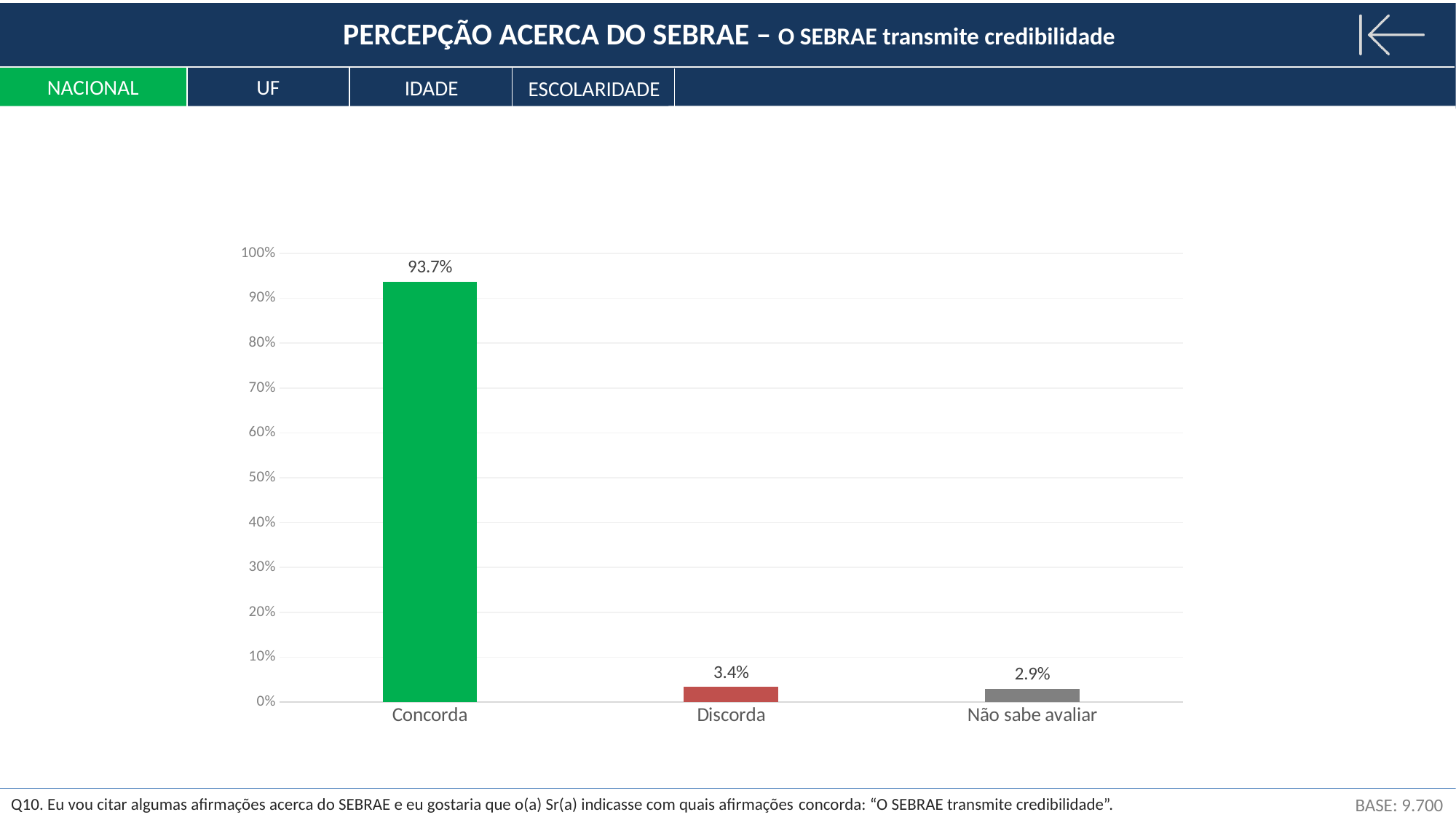
Which category has the lowest value? Não sabe avaliar What is the value for Discorda? 3.4% What is the value for Concorda? 93.7% What is the difference between the values for Discorda and Não sabe avaliar? 0.5% Which category has the highest value? Concorda What kind of chart is shown on the slide? bar chart Which is larger, the value for Discorda or the value for Não sabe avaliar? Discorda What is the value for Não sabe avaliar? 2.9% Is the value for Concorda greater or less than 90%? greater What is the difference between the values for Concorda and Discorda? 90.3% What colour is the bar for Concorda? green How many categories are shown in the chart? 3